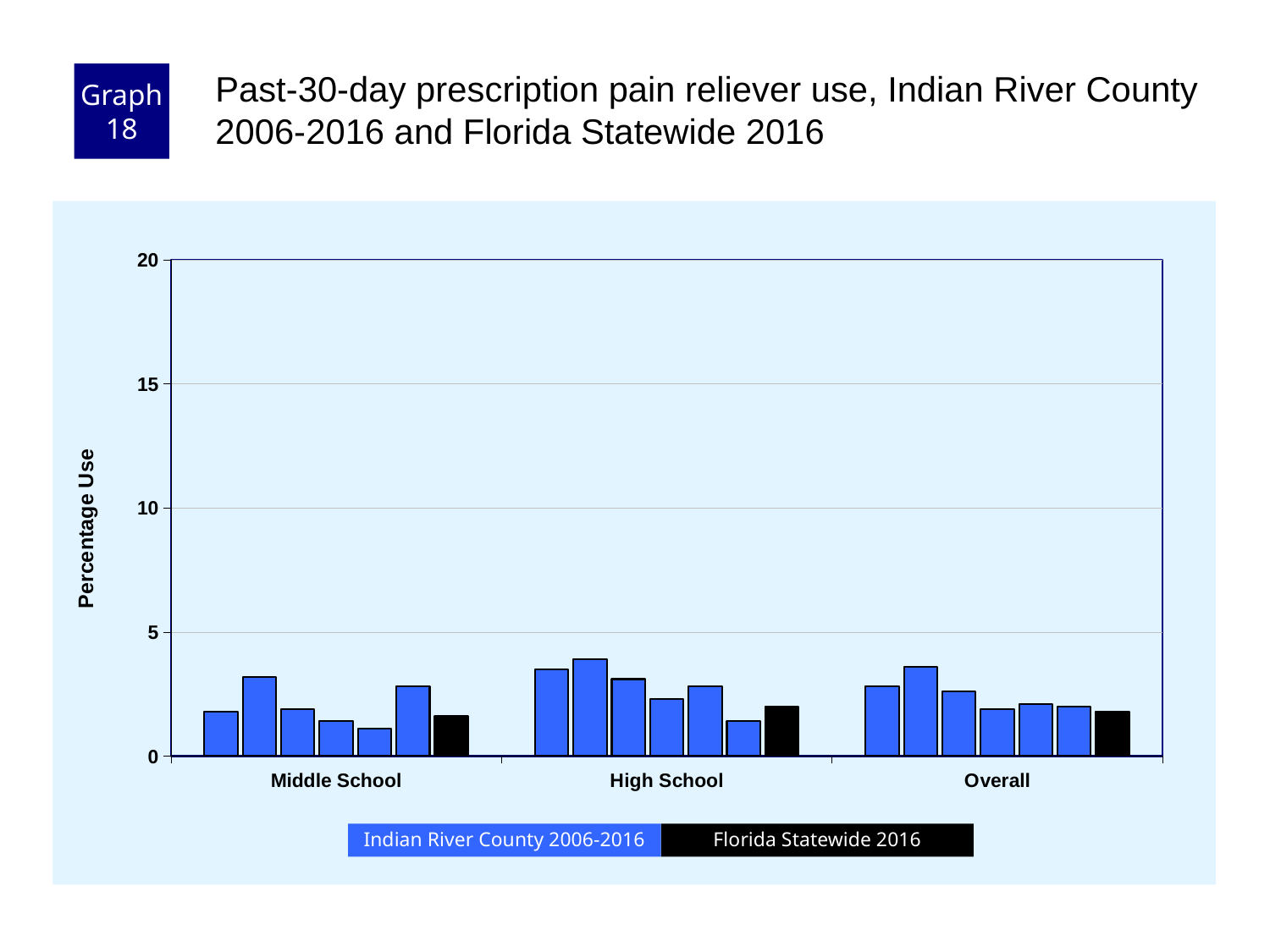
Is the Florida Statewide 2016 value for Middle School greater or less than 5? less What is the highest value shown on the y axis of the chart? 20 What is the title of the chart on the slide? Past-30-day prescription pain reliever use, Indian River County 2006-2016 and Florida Statewide 2016 Is the highest Indian River County 2006-2016 value for Middle School greater or less than 10? less Are any of the Indian River County 2006-2016 values for High School greater or less than 5? less How many categories are shown on the x axis of the chart? 3 How many series does the chart's legend list? 2 What is the label of the y axis of the chart? Percentage Use What kind of chart is shown on the slide? bar chart